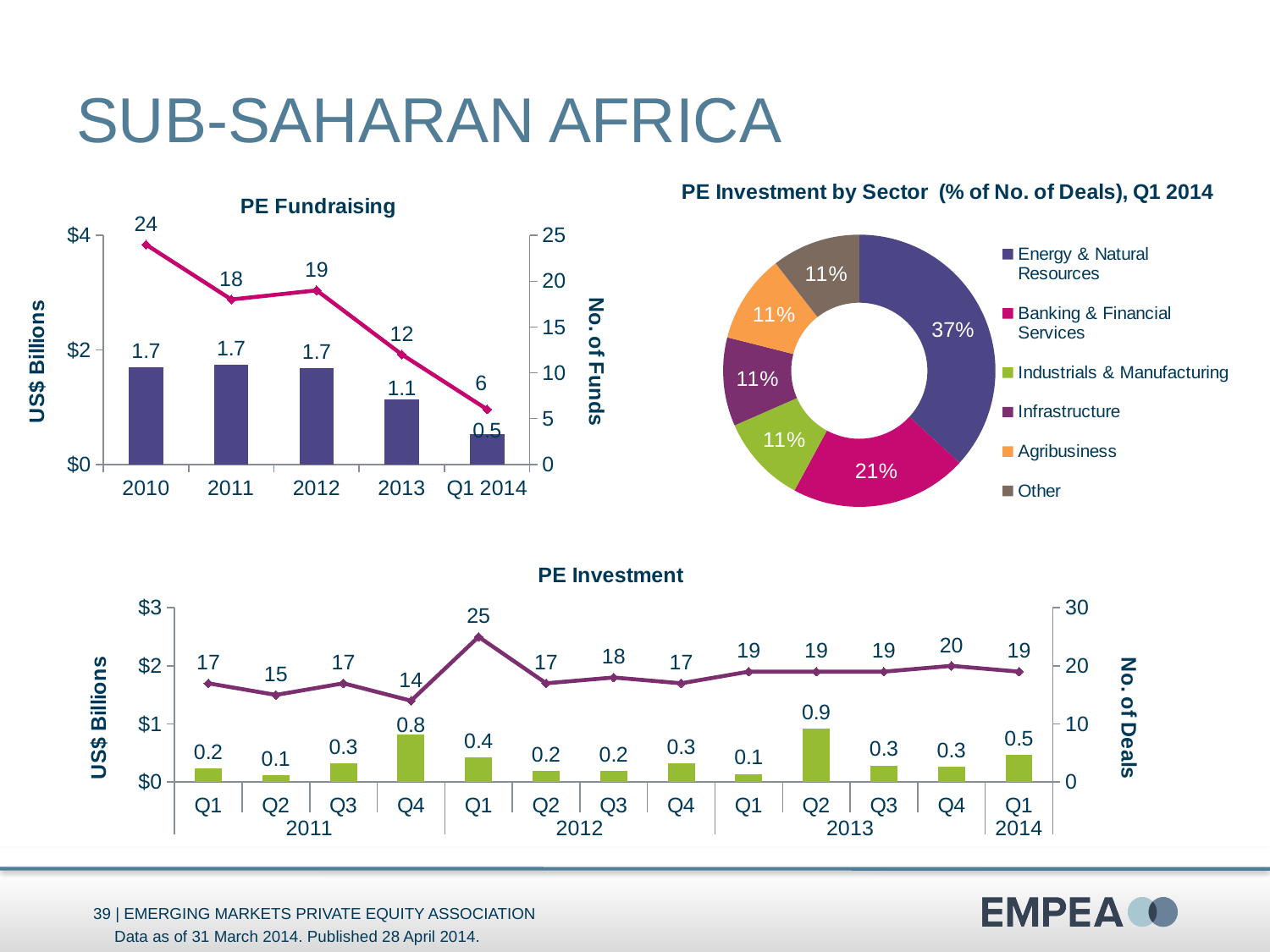
In the PE Investment by Sector chart, what share of deals was in Banking & Financial Services? 21% In the PE Investment chart, which is larger: the investment value for Q4 2011 or Q1 2014? Q4 2011 In the PE Fundraising chart, how many funds were raised in 2010? 24 In the PE Fundraising chart, what was the fundraising value in US$ billions for 2013? 1.1 In the PE Investment chart, which quarter had the highest number of deals? Q1 2012 In the PE Fundraising chart, what is the difference in the number of funds between 2010 and 2013? 12 In the PE Fundraising chart, which year had the lowest number of funds? Q1 2014 What kind of chart is the PE Investment by Sector chart? Pie (doughnut) chart How many sectors does the legend of the PE Investment by Sector chart list? 6 In the PE Investment by Sector chart, which sector has the largest share of deals? Energy & Natural Resources In the PE Fundraising chart, does the number of funds generally rise or fall from 2010 to Q1 2014? fall In the PE Investment chart, what was the investment value in US$ billions for Q2 2013? 0.9